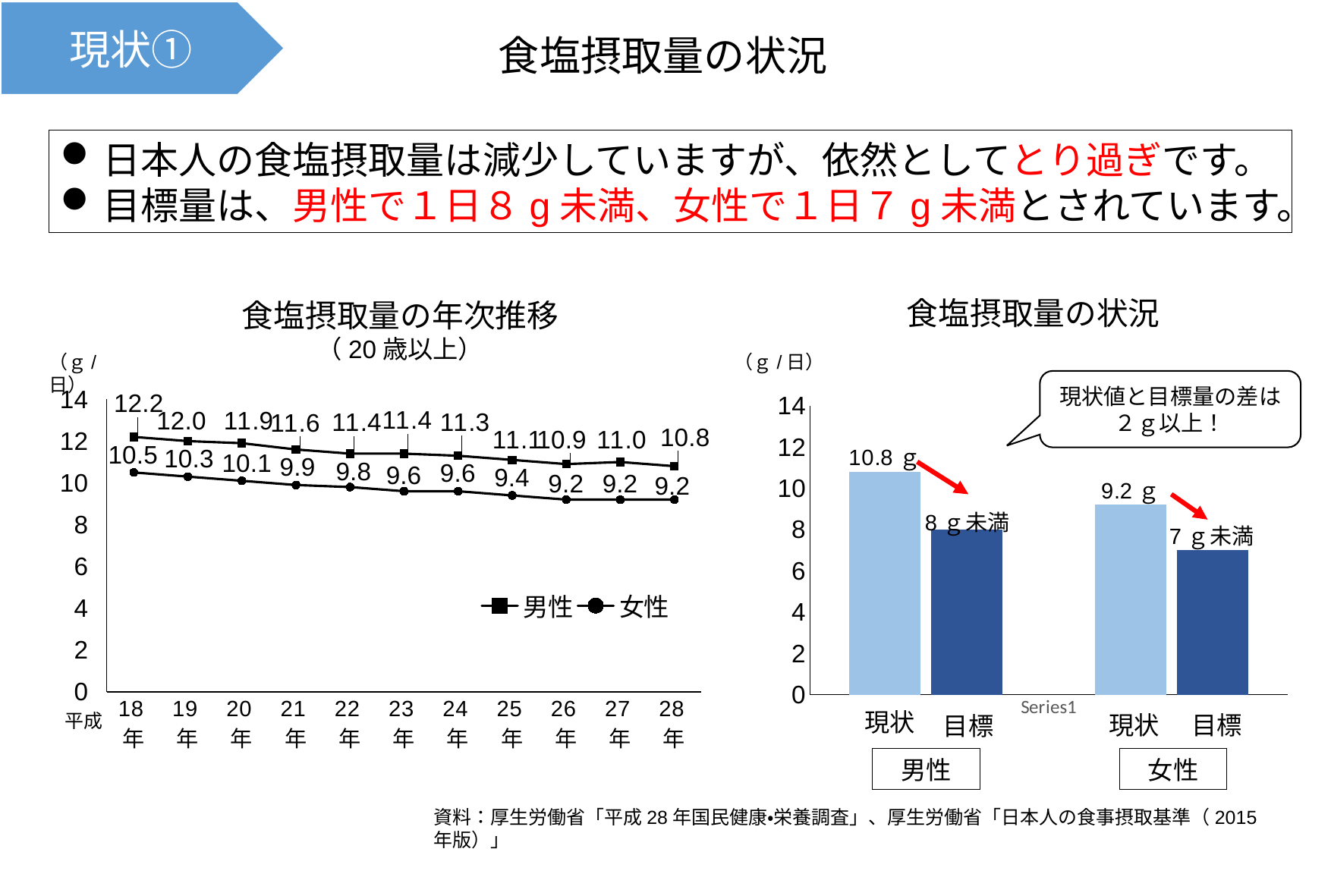
「食塩摂取量の状況」のグラフはどの種類のグラフですか？ 棒グラフ 「食塩摂取量の状況」のグラフで、女性の目標の値はいくつですか？ 7 g未満 「食塩摂取量の年次推移」のグラフで、平成18年から平成28年にかけて男性の値はいくつ減少しましたか？ 1.4 「食塩摂取量の状況」のグラフで、男性の現状の値はいくつですか？ 10.8 g 「食塩摂取量の年次推移」のグラフで、平成18年の男性の値はいくつですか？ 12.2 「食塩摂取量の年次推移」のグラフは、何年分のデータを示していますか？ 11 「食塩摂取量の年次推移」のグラフで、平成22年の男性の値はいくつですか？ 11.4 「食塩摂取量の年次推移」のグラフで、平成24年の男性と女性の値の差はいくつですか？ 1.7 「食塩摂取量の年次推移」のグラフで、女性の値は平成18年から平成28年にかけて上昇していますか、下降していますか？ 下降 「食塩摂取量の年次推移」のグラフの凡例には、いくつの系列がありますか？ 2 「食塩摂取量の年次推移」のグラフで、平成28年の女性の値はいくつですか？ 9.2 「食塩摂取量の年次推移」のグラフで、男性の値が最も高いのは何年ですか？ 平成18年